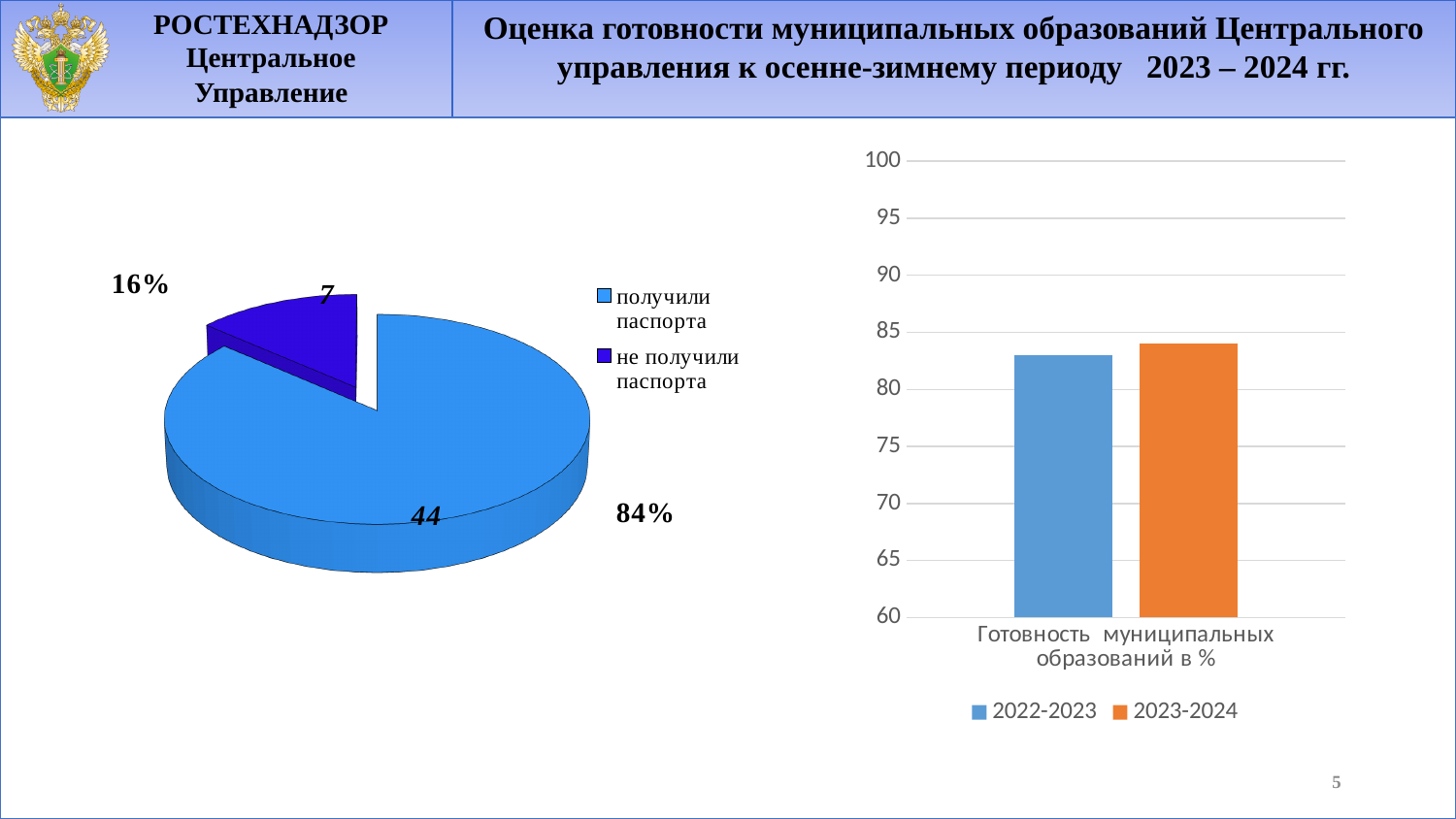
In the bar chart on the right, how many series does the legend list? 2 In the pie chart on the left, how many slices are there? 2 What kind of chart is shown on the left of the slide? Pie chart In the bar chart on the right, is the value for 2022-2023 greater or less than 80? greater In the pie chart on the left, what percentage share does the slice "получили паспорта" have? 84% In the pie chart on the left, what value is shown for the slice "получили паспорта"? 44 In the pie chart on the left, what is the difference between the values for "получили паспорта" and "не получили паспорта"? 37 In the pie chart on the left, what percentage share does the slice "не получили паспорта" have? 16% In the pie chart on the left, which slice is the smallest? не получили паспорта In the pie chart on the left, which slice is the largest? получили паспорта What kind of chart is shown on the right of the slide? Bar chart In the pie chart on the left, what value is shown for the slice "не получили паспорта"? 7